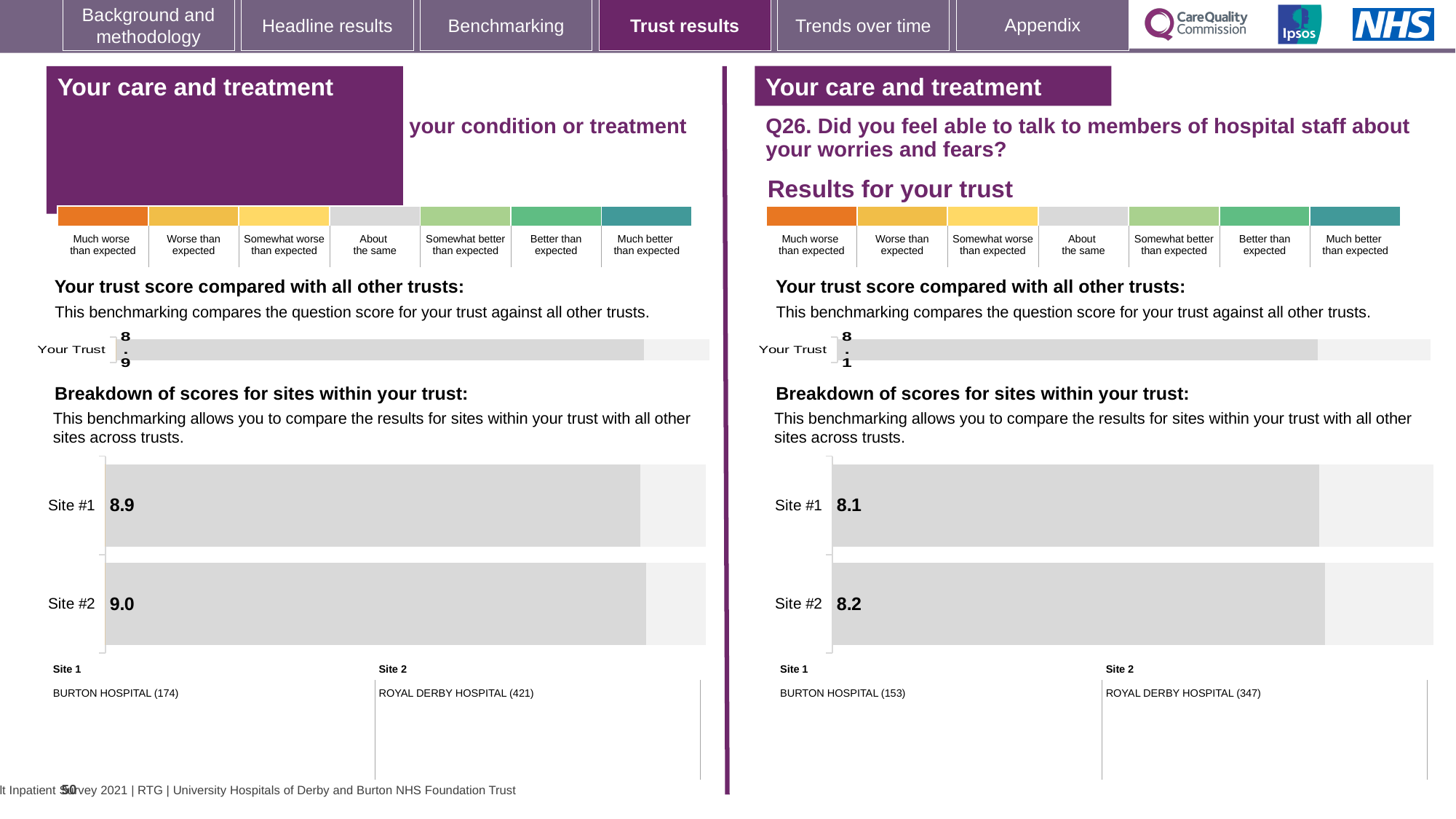
On the left panel's 'Your trust score compared with all other trusts' chart, what is the score for Your Trust? 8.9 How many sites are shown on the right panel (Q26) 'Breakdown of scores for sites within your trust' chart? 2 On the left panel's site breakdown chart, which site has the higher score? Site #2 On the left panel's 'Breakdown of scores for sites within your trust' chart, what is the score for Site #2? 9.0 What type of chart is used for the 'Breakdown of scores for sites within your trust' on the left panel? Bar chart On the left panel's 'Breakdown of scores for sites within your trust' chart, what is the score for Site #1? 8.9 On the left panel's site breakdown chart, what is the difference between the Site #2 and Site #1 scores? 0.1 On the right panel (Q26) site breakdown chart, what is the difference between the Site #2 and Site #1 scores? 0.1 On the right panel (Q26) 'Breakdown of scores for sites within your trust' chart, what is the score for Site #2? 8.2 On the right panel (Q26) 'Your trust score compared with all other trusts' chart, what is the score for Your Trust? 8.1 On the right panel (Q26) site breakdown chart, which site has the lower score? Site #1 On the right panel (Q26) 'Breakdown of scores for sites within your trust' chart, what is the score for Site #1? 8.1